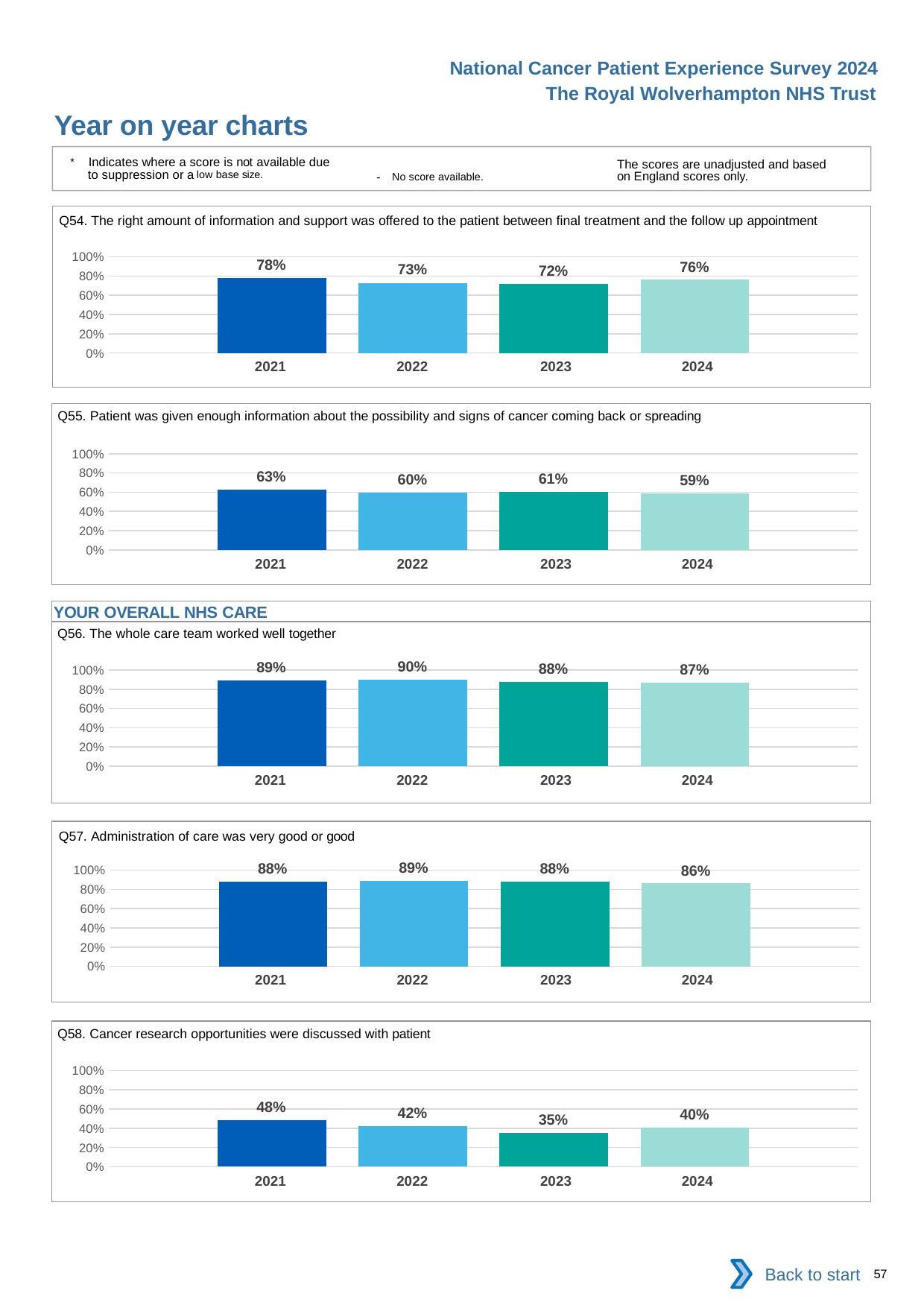
What type of chart is used for Q54? Bar chart In the Q55 chart, what is the value for 2024? 59% In the Q54 chart, which year has the lowest value? 2023 In the Q54 chart, what is the value for 2021? 78% In the Q58 chart, what is the difference between the 2021 and 2023 values? 13 percentage points How many years are shown in the Q58 chart? 4 In the Q57 chart, is the value for 2022 larger or smaller than the value for 2024? larger In the Q57 chart, what is the value for 2024? 86% In the Q55 chart, what is the difference between the 2021 and 2024 values? 4 percentage points In the Q58 chart, which year has the lowest value? 2023 In the Q56 chart, which year has the highest value? 2022 In the Q56 chart, what is the value for 2023? 88%